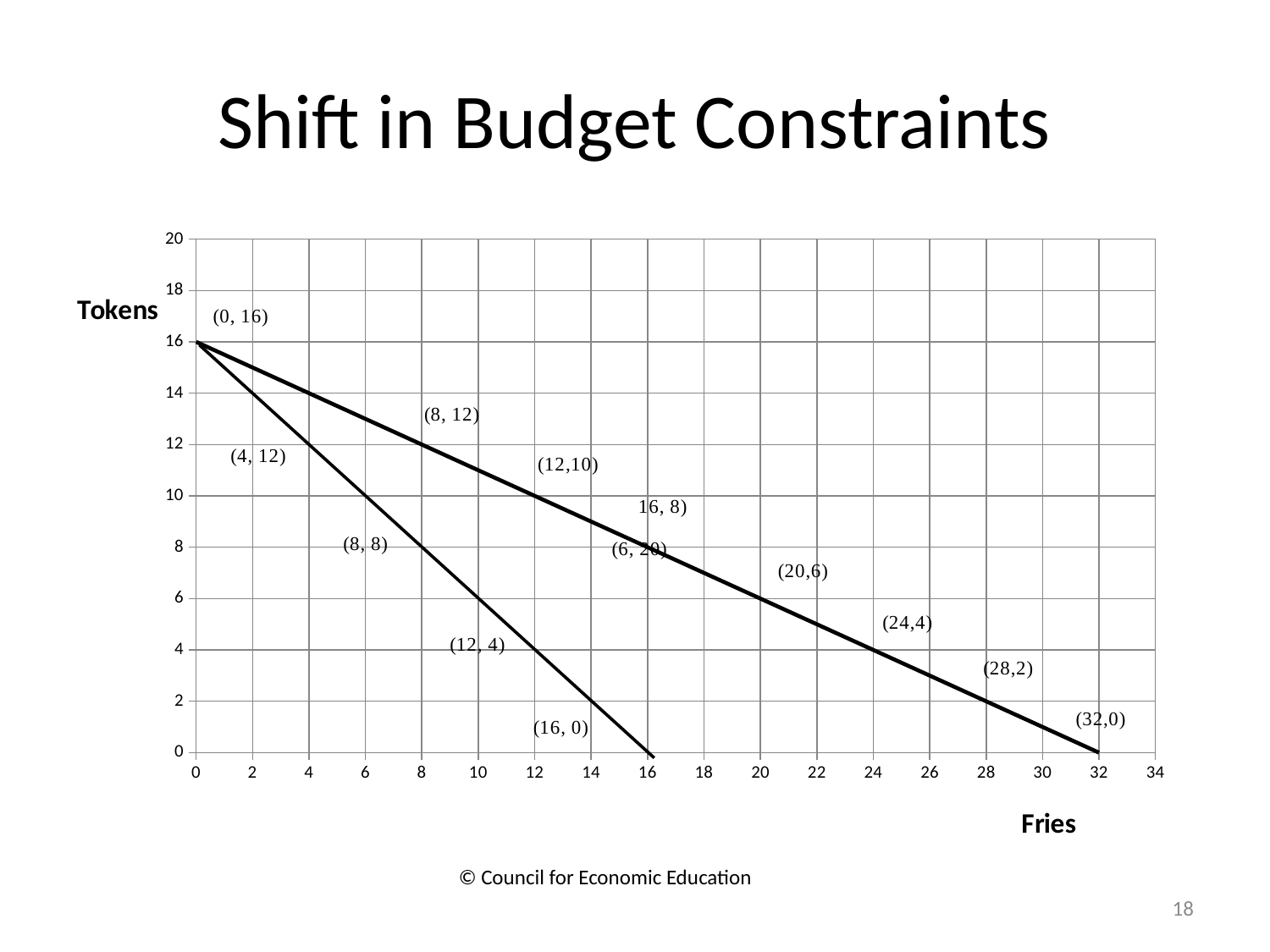
What is the title of the chart? Shift in Budget Constraints What kind of chart is shown on the slide? line chart On the line that ends at (16, 0), how many tokens correspond to 8 fries? 8 At how many fries does the line ending at (16, 0) reach 0 tokens? 16 What label is on the vertical axis of the chart? Tokens How many lines are plotted on the chart? 2 At 8 fries, what is the difference in tokens between the line ending at (32,0) and the line ending at (16, 0)? 4 Do the token values rise or fall as the number of fries increases along the x axis? fall At how many fries does the line ending at (32,0) reach 0 tokens? 32 At 12 fries, which line has more tokens: the line ending at (16, 0) or the line ending at (32,0)? the line ending at (32,0) On the line that ends at (32,0), how many tokens correspond to 24 fries? 4 How many tokens do both lines start with at 0 fries? 16